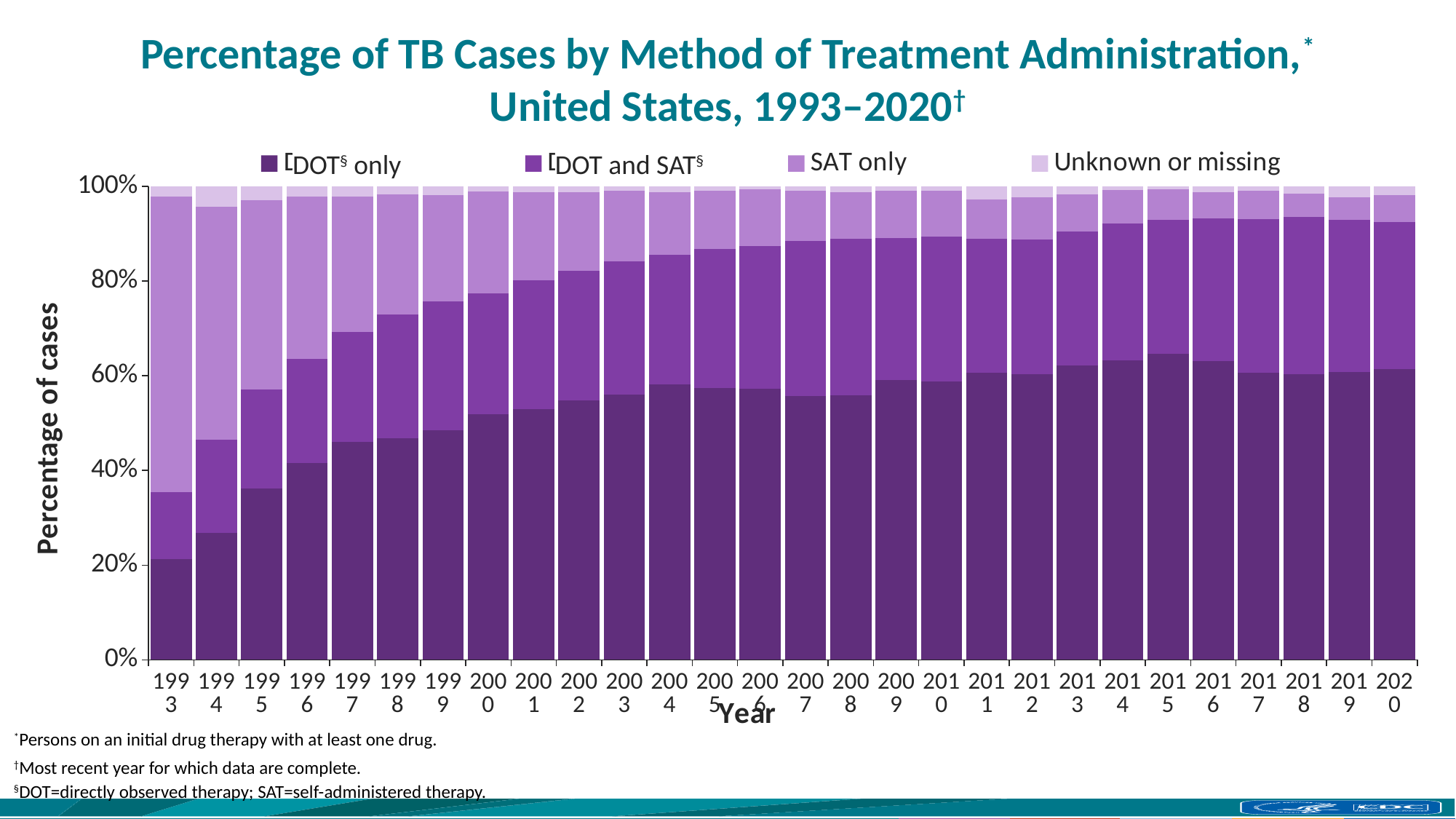
Is the DOT only share in 1993 greater or less than 40%? less In which year is the SAT only share the highest? 1993 What is the title of the chart? Percentage of TB Cases by Method of Treatment Administration, United States, 1993–2020 What kind of chart is shown on the slide? Stacked bar chart What is the label of the y axis? Percentage of cases Which year has the larger DOT only share, 1993 or 2020? 2020 Does the SAT only share generally rise or fall from 1993 to 2020? Fall In which year is the DOT only share the lowest? 1993 Is the DOT only share in 2020 greater or less than 40%? greater How many series does the legend list? 4 Does the DOT only share generally rise or fall from 1993 to 2020? Rise How many years are shown along the x axis? 28